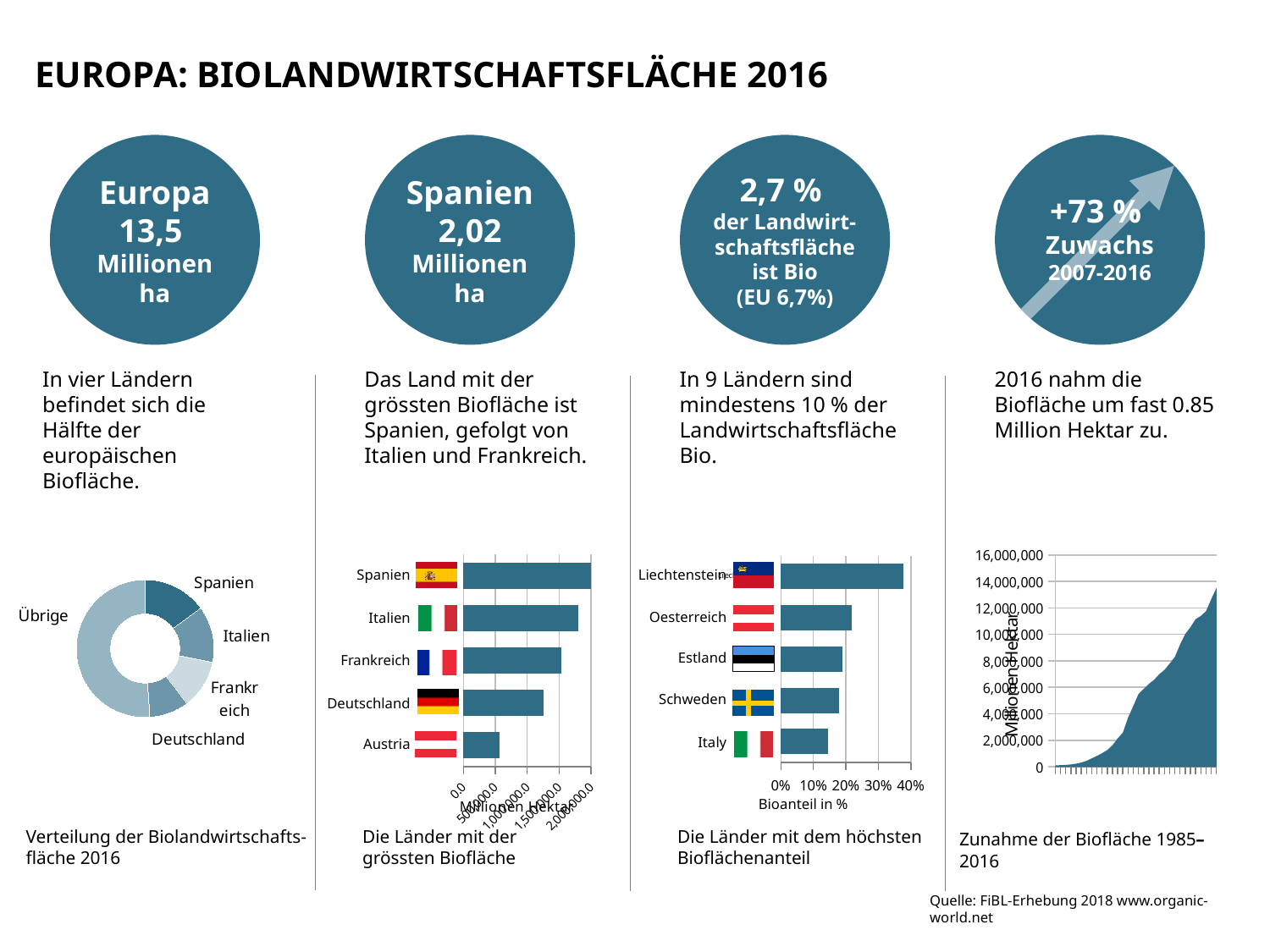
In the chart 'Die Länder mit der grössten Biofläche', is the value for Austria greater or less than 1,000,000.0? less In the chart 'Die Länder mit der grössten Biofläche', which is larger, Italien or Frankreich? Italien In the chart 'Die Länder mit dem höchsten Bioflächenanteil', which country has the highest share? Liechtenstein In the chart 'Die Länder mit dem höchsten Bioflächenanteil', what is the label of the x axis? Bioanteil in % In the chart 'Verteilung der Biolandwirtschaftsfläche 2016', how many slices are shown? 5 In the chart 'Zunahme der Biofläche 1985–2016', do the values rise or fall over time? Rise What kind of chart is the chart titled 'Verteilung der Biolandwirtschaftsfläche 2016'? Donut (pie) chart In the chart 'Verteilung der Biolandwirtschaftsfläche 2016', which named country has the largest slice? Spanien In the chart 'Die Länder mit dem höchsten Bioflächenanteil', is the value for Liechtenstein greater or less than 30%? greater In the chart 'Die Länder mit der grössten Biofläche', which country has the highest value? Spanien In the chart 'Die Länder mit der grössten Biofläche', which country has the lowest value? Austria What kind of chart is 'Die Länder mit der grössten Biofläche'? Bar chart